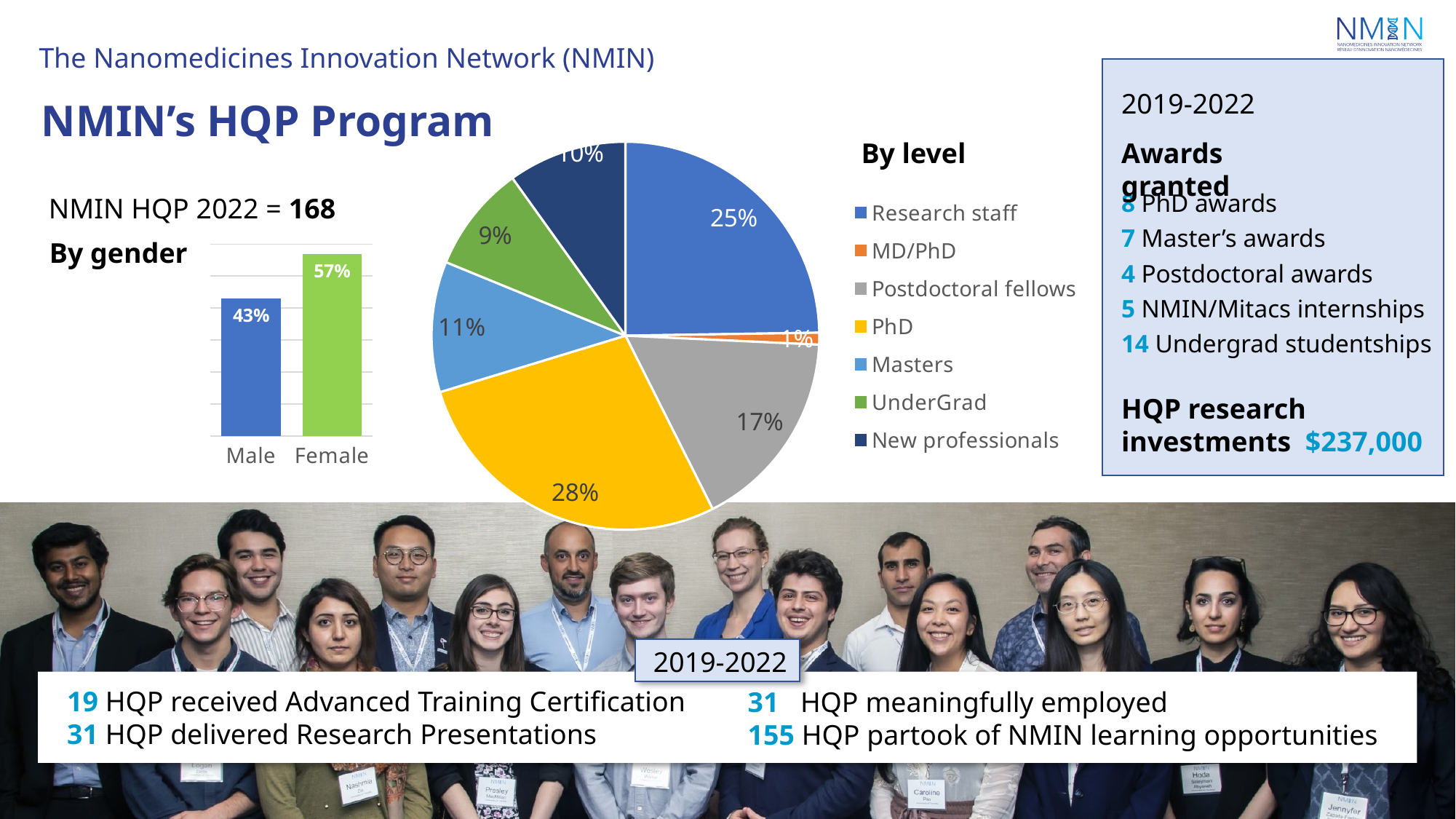
In the 'By level' pie chart, what is the difference between the Postdoctoral fellows share and the Masters share? 6% In the 'By level' pie chart, which is larger, UnderGrad or New professionals? New professionals What kind of chart is the 'By gender' chart? Bar chart How many categories does the legend of the 'By level' pie chart list? 7 In the 'By level' pie chart, what share is Research staff? 25% In the 'By gender' bar chart, which category is higher, Male or Female? Female In the 'By level' pie chart, which category has the largest share? PhD In the 'By gender' bar chart, what is the value for Male? 43% In the 'By gender' bar chart, what is the value for Female? 57% In the 'By level' pie chart, which category has the smallest share? MD/PhD In the 'By level' pie chart, what share is PhD? 28% In the 'By gender' bar chart, what is the difference between the Female and Male values? 14%